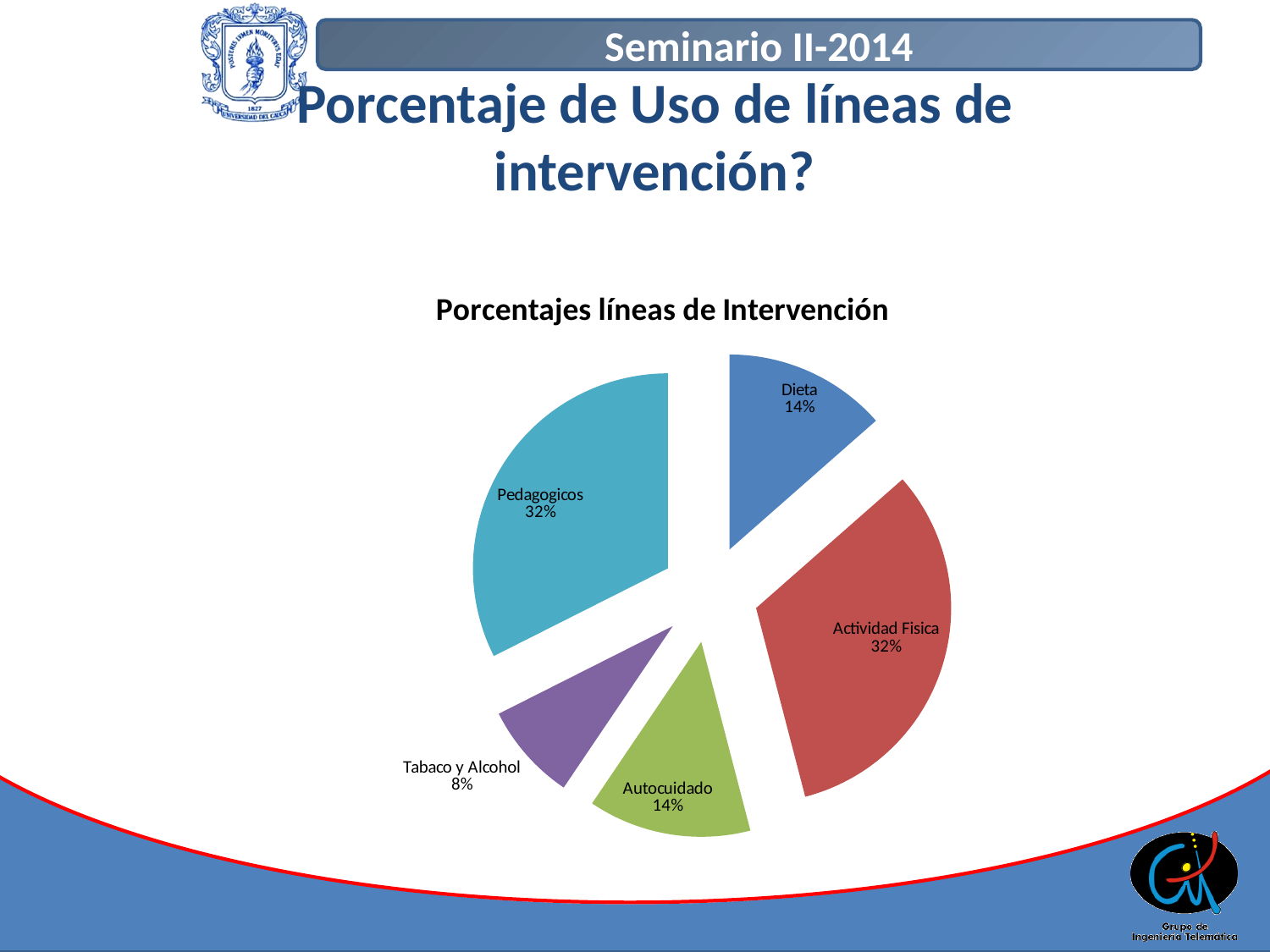
What type of chart is shown on the slide? Pie chart Which is larger, the Pedagogicos slice or the Autocuidado slice? Pedagogicos What percentage does the Actividad Fisica slice represent? 32% What is the title of the chart? Porcentajes líneas de Intervención What percentage does the Dieta slice represent? 14% What percentage does the Pedagogicos slice represent? 32% What colour is the Actividad Fisica slice? Red Which category has the smallest slice of the pie? Tabaco y Alcohol What percentage does the Autocuidado slice represent? 14% What percentage does the Tabaco y Alcohol slice represent? 8% How many categories are shown in the pie chart? 5 What is the difference in percentage points between Actividad Fisica and Tabaco y Alcohol? 24